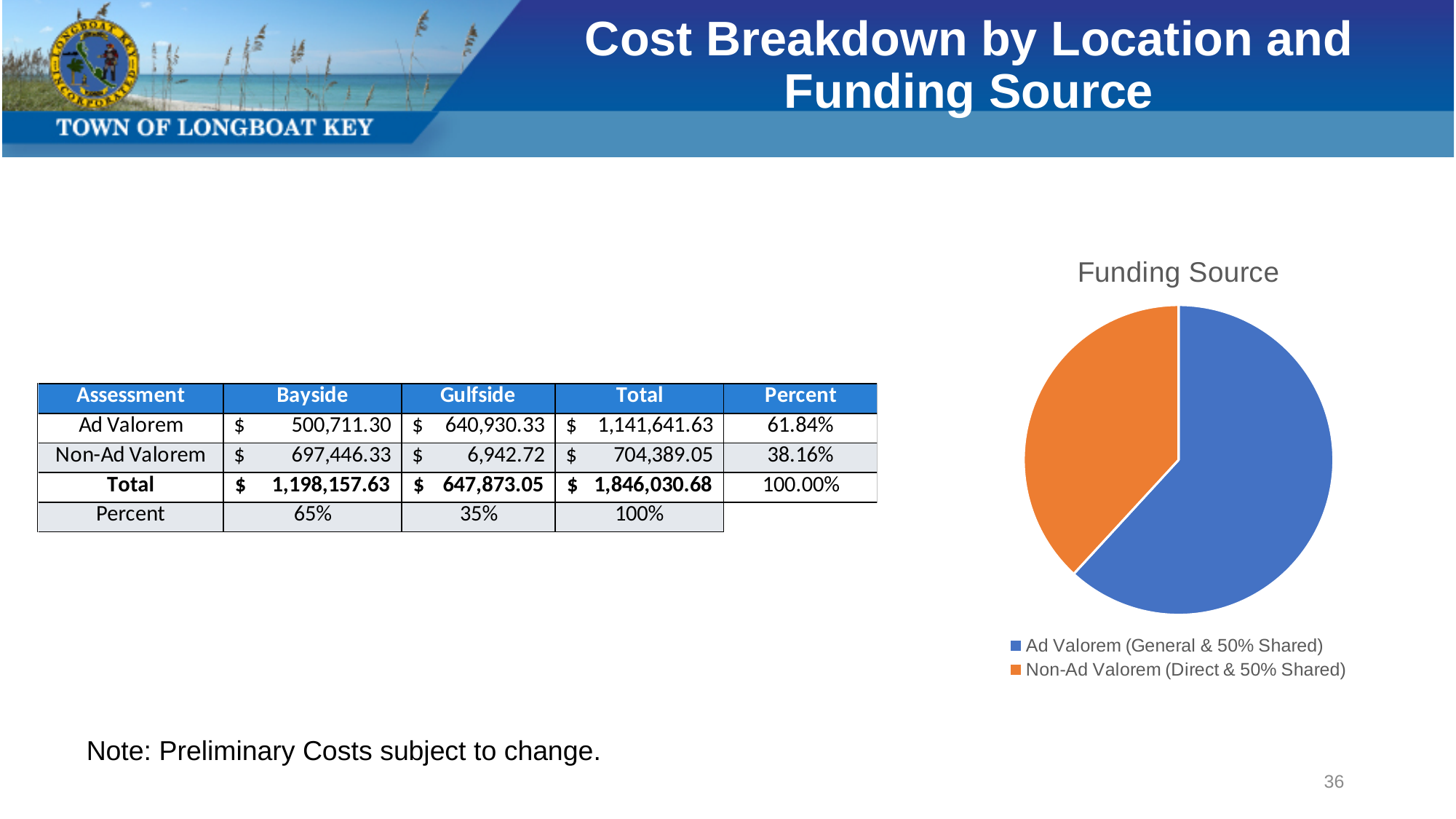
How many entries does the legend of the Funding Source pie chart list? 2 In the Funding Source pie chart, which is larger: the Ad Valorem slice or the Non-Ad Valorem slice? Ad Valorem (General & 50% Shared) What colour is the Non-Ad Valorem (Direct & 50% Shared) slice in the Funding Source pie chart? orange Which slice of the Funding Source pie chart is the smallest? Non-Ad Valorem (Direct & 50% Shared) What is the title of the pie chart on the slide? Funding Source What kind of chart is the Funding Source chart? pie chart How many slices does the Funding Source pie chart have? 2 In the Funding Source pie chart, does the Ad Valorem slice take up more or less than half of the pie? more Which slice of the Funding Source pie chart is the largest? Ad Valorem (General & 50% Shared)